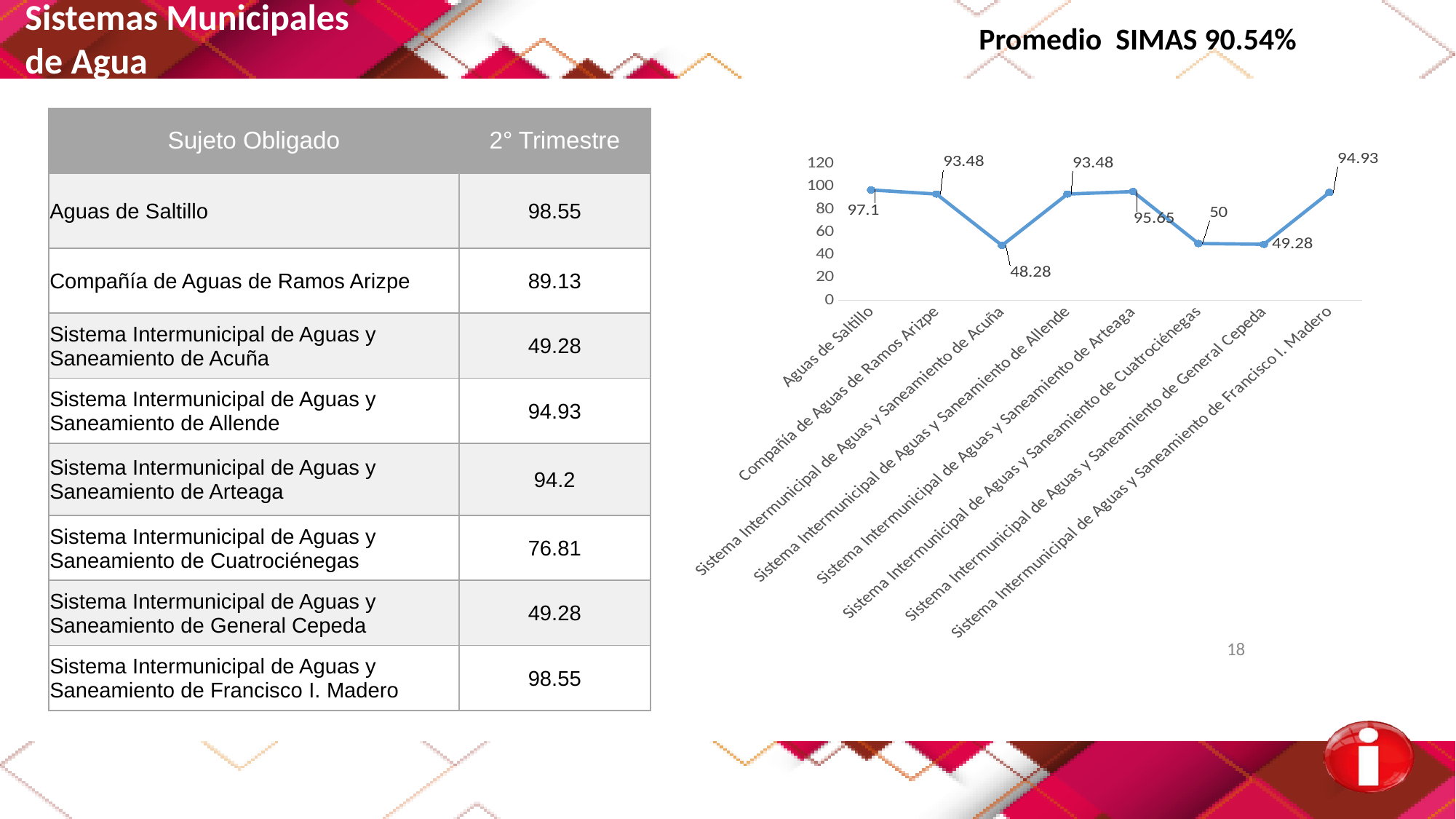
On the line chart, what is the value for Sistema Intermunicipal de Aguas y Saneamiento de Cuatrociénegas? 50 On the line chart, which category has the highest value? Aguas de Saltillo On the line chart, what is the value for Aguas de Saltillo? 97.1 On the line chart, what is the difference between the value for Aguas de Saltillo and the value for Sistema Intermunicipal de Aguas y Saneamiento de Acuña? 48.82 How many categories are plotted on the line chart? 8 On the line chart, what is the value for Sistema Intermunicipal de Aguas y Saneamiento de Arteaga? 95.65 On the line chart, is the value for Sistema Intermunicipal de Aguas y Saneamiento de Allende greater or less than 80? greater On the line chart, which category has the lowest value? Sistema Intermunicipal de Aguas y Saneamiento de Acuña On the line chart, what is the value for Sistema Intermunicipal de Aguas y Saneamiento de Acuña? 48.28 On the line chart, does the line rise or fall from Sistema Intermunicipal de Aguas y Saneamiento de Arteaga to Sistema Intermunicipal de Aguas y Saneamiento de Cuatrociénegas? fall What type of chart is shown on the right side of the slide? line chart On the line chart, which is larger: the value for Aguas de Saltillo or the value for Sistema Intermunicipal de Aguas y Saneamiento de General Cepeda? Aguas de Saltillo